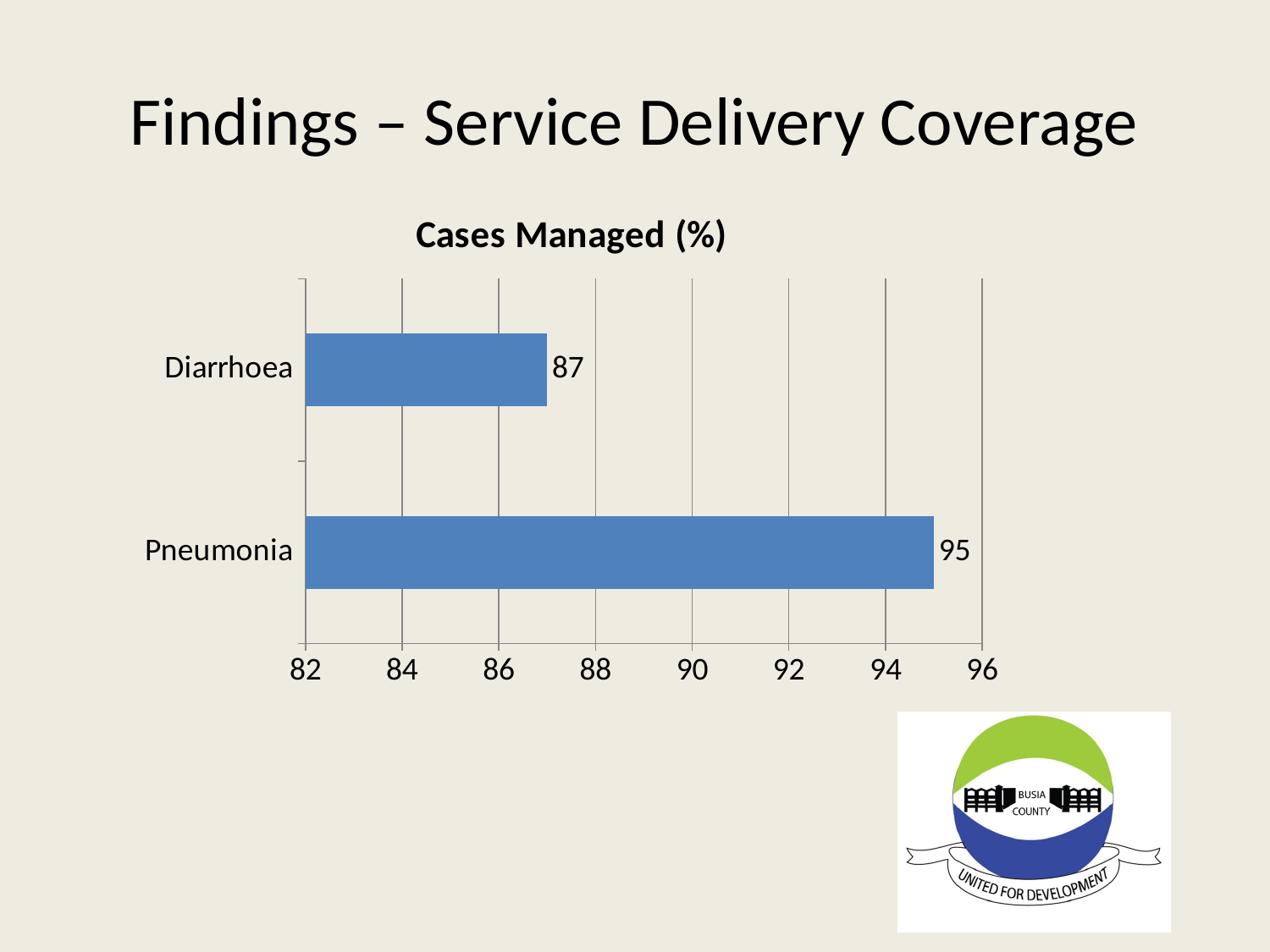
Which category has the highest value in the Cases Managed (%) chart? Pneumonia Which category has the lowest value in the Cases Managed (%) chart? Diarrhoea Which is larger, the value for Diarrhoea or the value for Pneumonia? Pneumonia What is the difference between the values for Pneumonia and Diarrhoea? 8 Is the value for Diarrhoea greater or less than 90? less Is the value for Pneumonia greater or less than 94? greater How many categories are shown in the Cases Managed (%) chart? 2 What is the value for Diarrhoea in the Cases Managed (%) chart? 87 What is the title of the chart on the slide? Cases Managed (%) What is the maximum value shown on the horizontal axis of the chart? 96 What kind of chart is shown on the slide? bar chart What is the value for Pneumonia in the Cases Managed (%) chart? 95